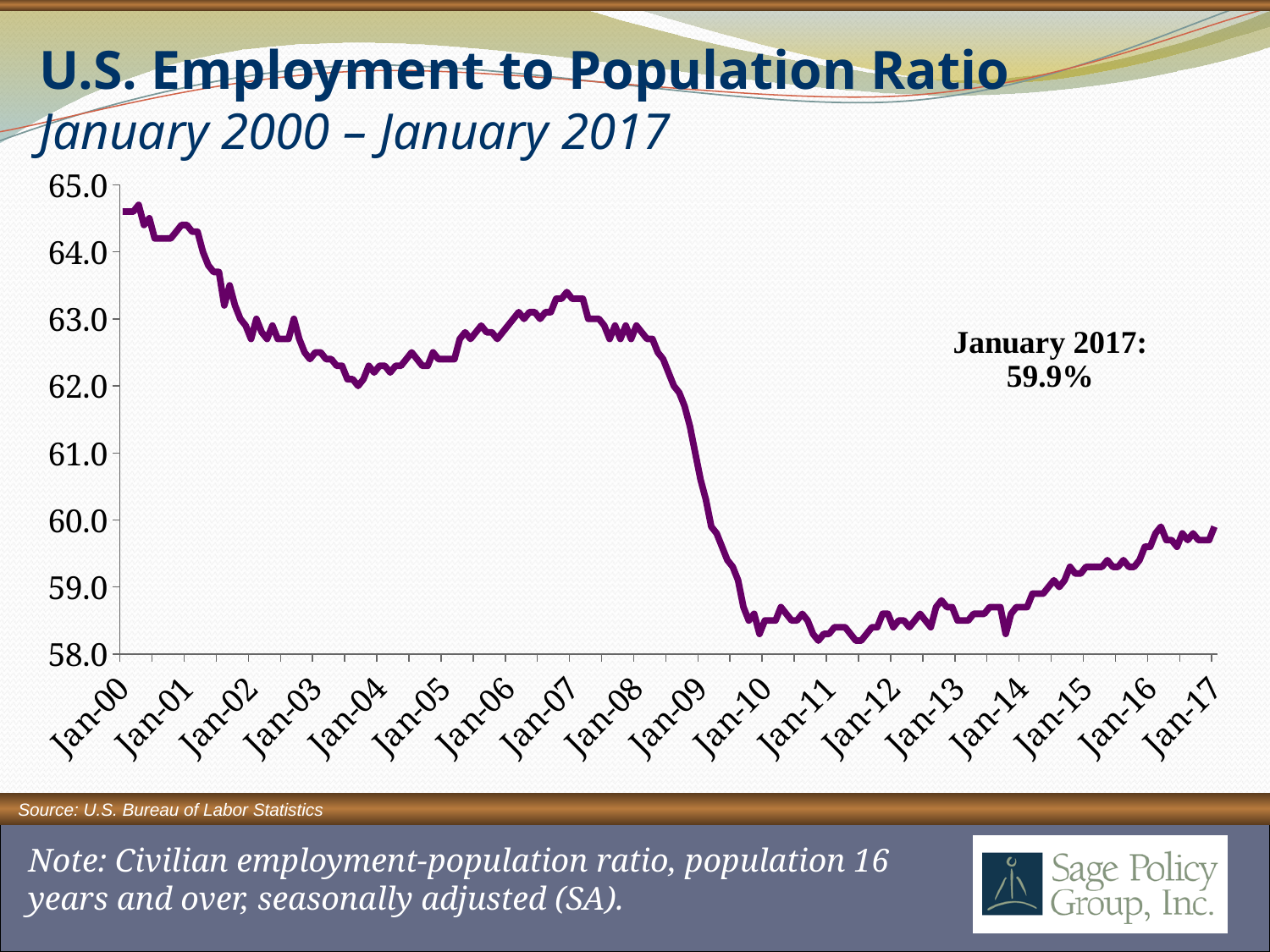
Is the value for Jan-00 greater or less than 64.0? greater Does the line rise or fall between Jan-12 and Jan-17? Rise Which is larger, the value at Jan-07 or the value at Jan-11? Jan-07 Is the value for Jan-10 greater or less than 59.0? less Is the value for Jan-15 greater or less than 60.0? less Does the line rise or fall between Jan-08 and Jan-10? Fall What is the employment to population ratio for January 2017 according to the label on the chart? 59.9% What source is cited for the chart data? U.S. Bureau of Labor Statistics How many year labels are shown on the x axis? 18 Which is larger, the value at Jan-00 or the value at Jan-17? Jan-00 What kind of chart is shown on the slide? Line chart